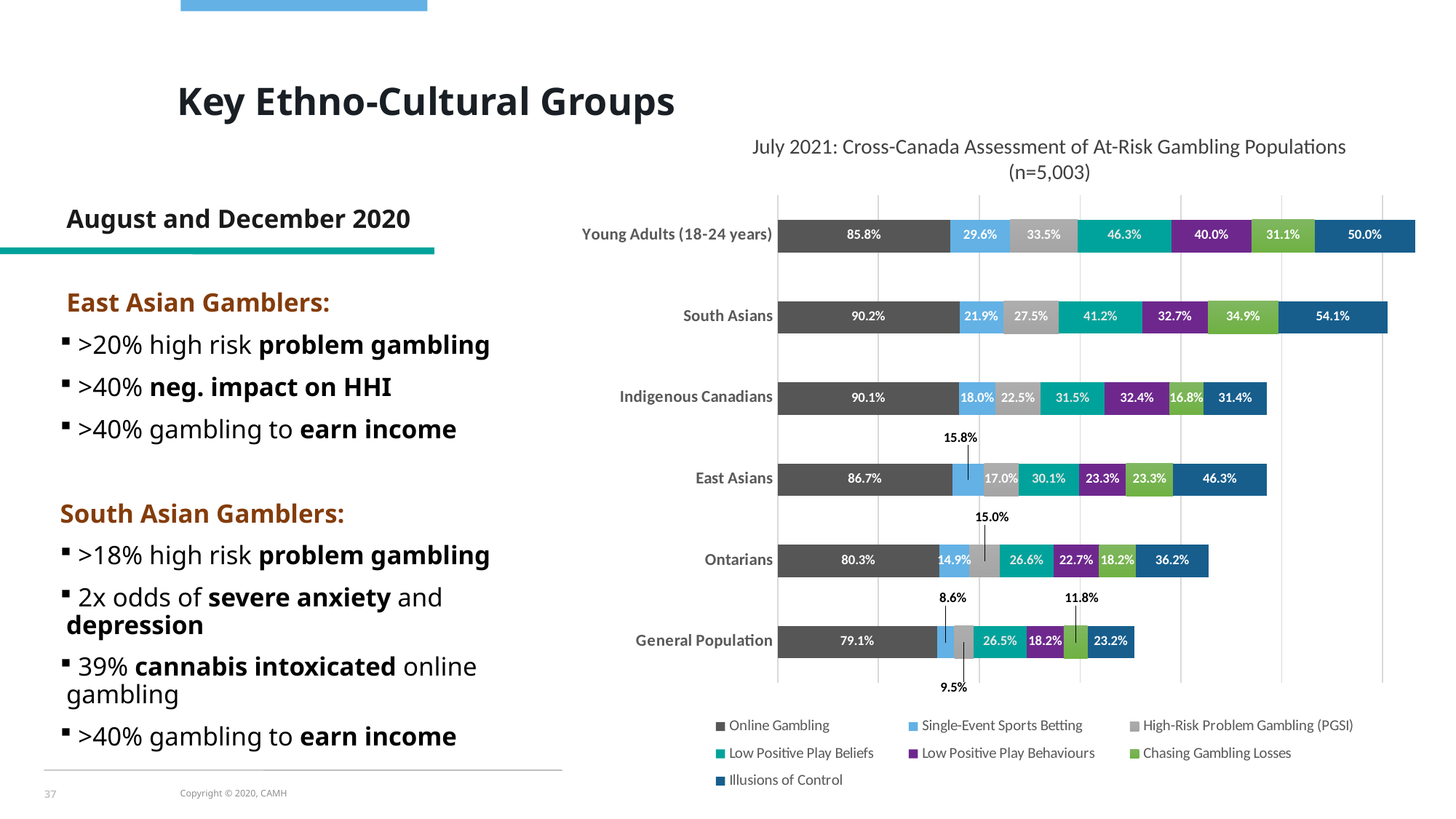
What is the title of the chart? July 2021: Cross-Canada Assessment of At-Risk Gambling Populations (n=5,003) What is the Single-Event Sports Betting value for the General Population? 8.6% Which group has the lowest Online Gambling value? General Population What kind of chart is shown on the slide? Stacked bar chart How many population groups are shown in the chart? 6 How many series does the legend list? 7 What is the High-Risk Problem Gambling (PGSI) value for Ontarians? 15.0% Which has a higher Chasing Gambling Losses value, South Asians or Young Adults (18-24 years)? South Asians What is the Online Gambling value for South Asians? 90.2% What is the difference between the Online Gambling values for Young Adults (18-24 years) and the General Population? 6.7 percentage points What is the Illusions of Control value for East Asians? 46.3% Which group has the highest Illusions of Control value? South Asians